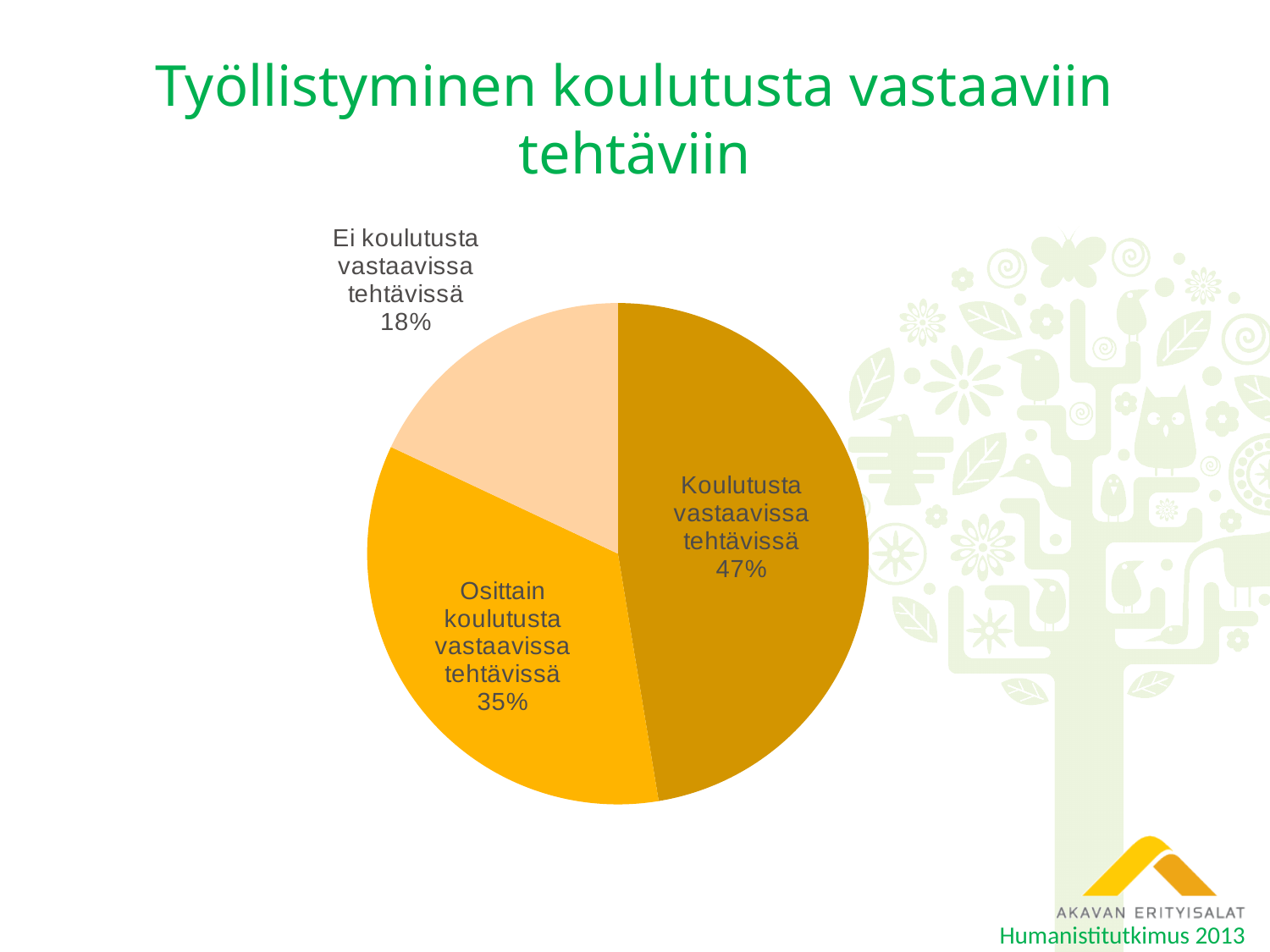
How many slices does the pie chart have? 3 What is the difference in percentage points between 'Koulutusta vastaavissa tehtävissä' and 'Osittain koulutusta vastaavissa tehtävissä'? 12 What is the difference in percentage points between 'Osittain koulutusta vastaavissa tehtävissä' and 'Ei koulutusta vastaavissa tehtävissä'? 17 What share of the pie is 'Ei koulutusta vastaavissa tehtävissä'? 18% What share of the pie is 'Osittain koulutusta vastaavissa tehtävissä'? 35% Which slice of the pie is the smallest? Ei koulutusta vastaavissa tehtävissä Which slice of the pie is shown in the lightest colour? Ei koulutusta vastaavissa tehtävissä Which is larger: the share for 'Osittain koulutusta vastaavissa tehtävissä' or for 'Ei koulutusta vastaavissa tehtävissä'? Osittain koulutusta vastaavissa tehtävissä What share of the pie is 'Koulutusta vastaavissa tehtävissä'? 47% What kind of chart is shown on the slide? pie chart Which slice of the pie is the largest? Koulutusta vastaavissa tehtävissä What is the title of the slide containing the pie chart? Työllistyminen koulutusta vastaaviin tehtäviin